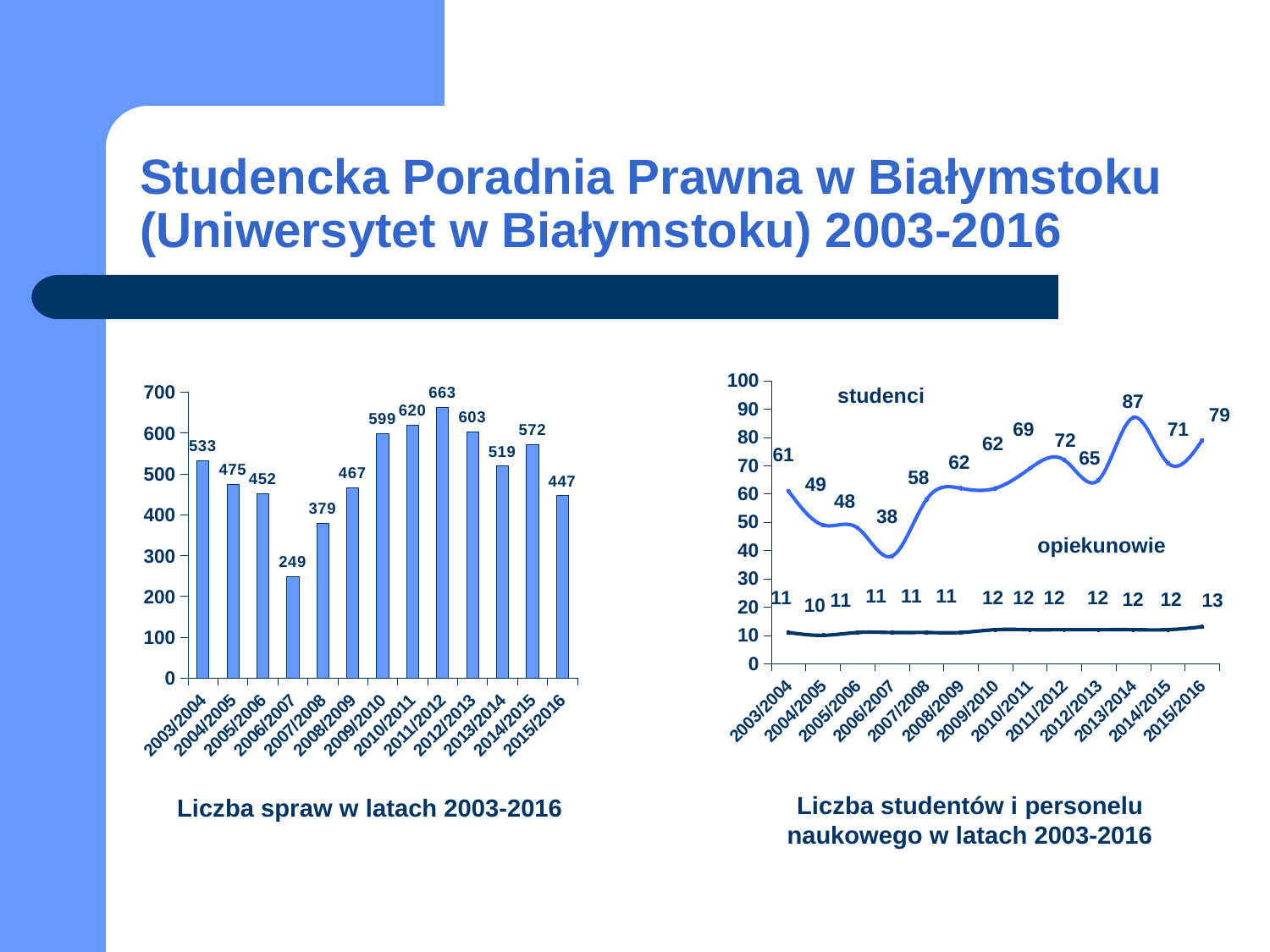
In the left chart (Liczba spraw w latach 2003-2016), which year has the highest value? 2011/2012 In the left chart (Liczba spraw w latach 2003-2016), what is the value for 2006/2007? 249 What kind of chart is the right chart (Liczba studentów i personelu naukowego w latach 2003-2016)? line chart In the left chart (Liczba spraw w latach 2003-2016), which is larger, the value for 2003/2004 or the value for 2013/2014? 2003/2004 In the left chart (Liczba spraw w latach 2003-2016), how many years are shown on the x axis? 13 In the left chart (Liczba spraw w latach 2003-2016), which year has the lowest value? 2006/2007 In the left chart (Liczba spraw w latach 2003-2016), what is the difference between the values for 2011/2012 and 2015/2016? 216 In the right chart (Liczba studentów i personelu naukowego w latach 2003-2016), what is the value for opiekunowie in 2015/2016? 13 In the right chart (Liczba studentów i personelu naukowego w latach 2003-2016), in which year is the studenci value lowest? 2006/2007 What kind of chart is the left chart (Liczba spraw w latach 2003-2016)? bar chart In the right chart (Liczba studentów i personelu naukowego w latach 2003-2016), what is the difference between studenci and opiekunowie in 2003/2004? 50 In the right chart (Liczba studentów i personelu naukowego w latach 2003-2016), what is the value for studenci in 2013/2014? 87